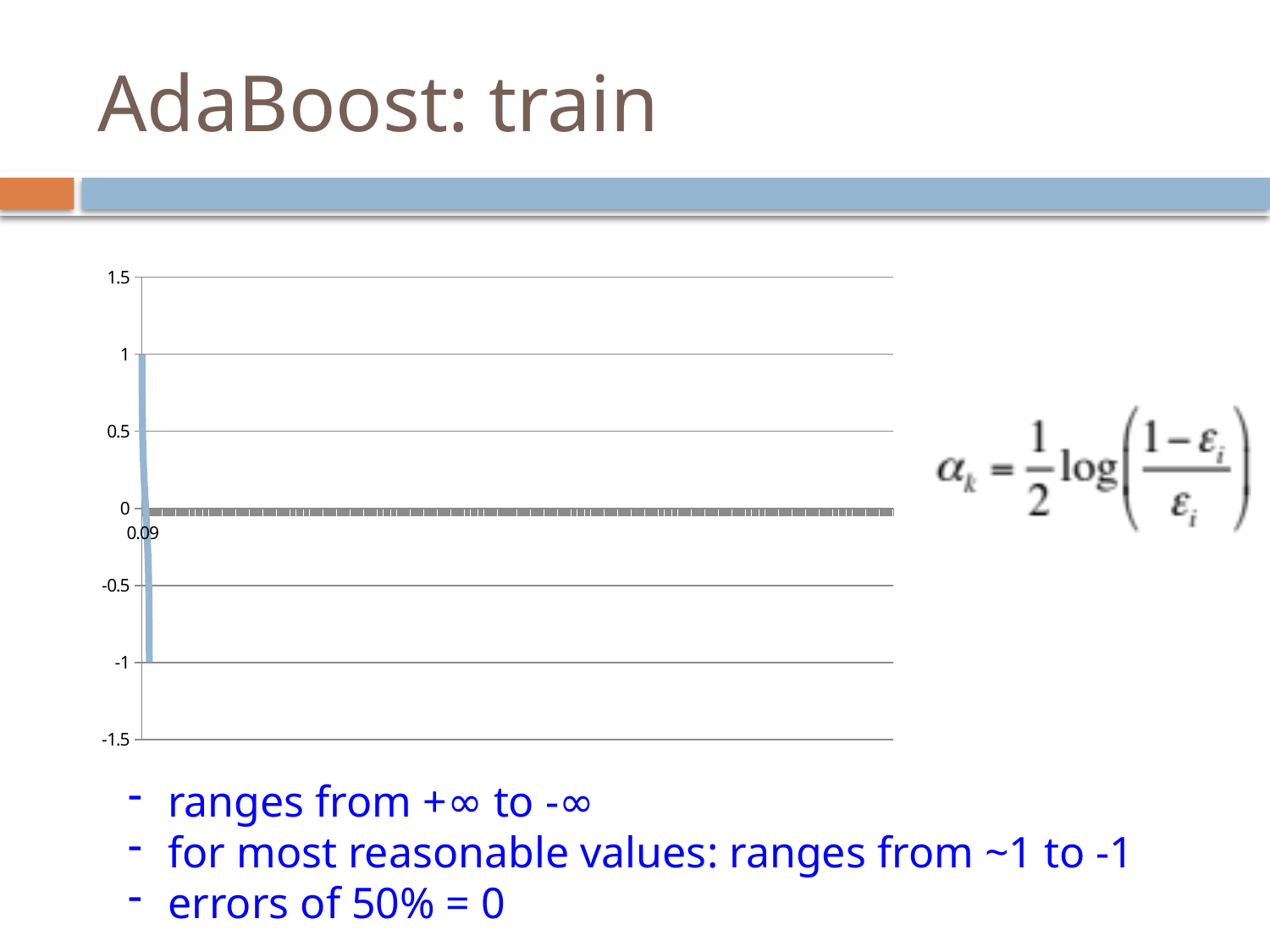
Is the highest point of the plotted line greater or less than 0.5? greater Is the lowest point of the plotted line greater or less than -0.5? less How many tick labels are shown on the y axis of the chart? 7 Do the plotted values rise or fall as you move along the x axis? fall What is the only x-axis label readable on the chart? 0.09 What is the highest value labelled on the y axis of the chart? 1.5 What is the lowest value labelled on the y axis of the chart? -1.5 What kind of chart is shown on the slide? line chart